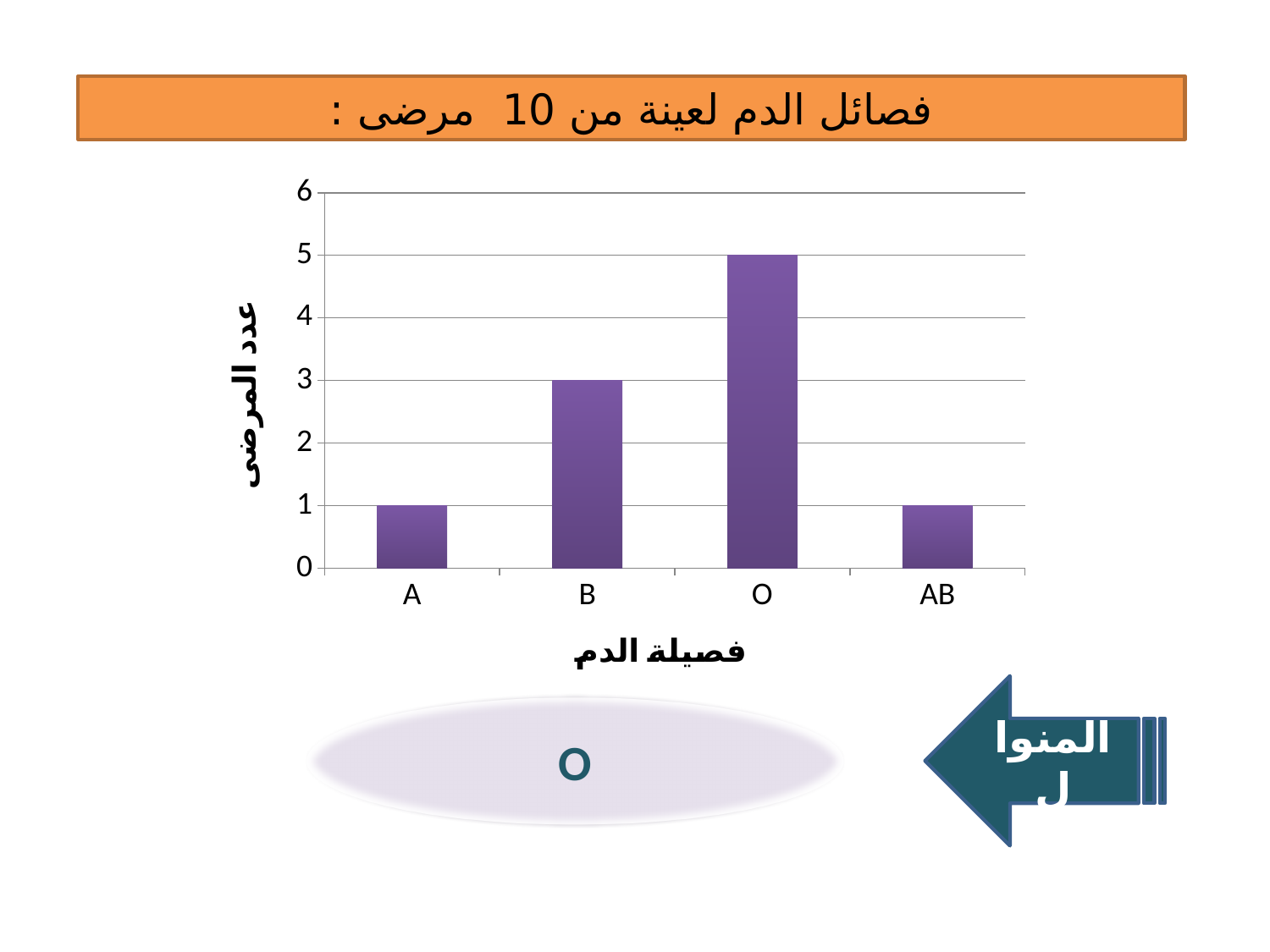
How many blood type categories are shown on the x axis? 4 What type of chart is shown on the slide? bar chart Which has more patients, blood type B or blood type AB? B What is the number of patients for blood type A? 1 What is the difference between the number of patients with blood type O and blood type B? 2 What is the label of the y axis? عدد المرضى What is the number of patients for blood type O? 5 What is the number of patients for blood type B? 3 What is the label of the x axis? فصيلة الدم What is the number of patients for blood type AB? 1 Which blood type has the highest number of patients? O Is the value for blood type O greater or less than 4? greater